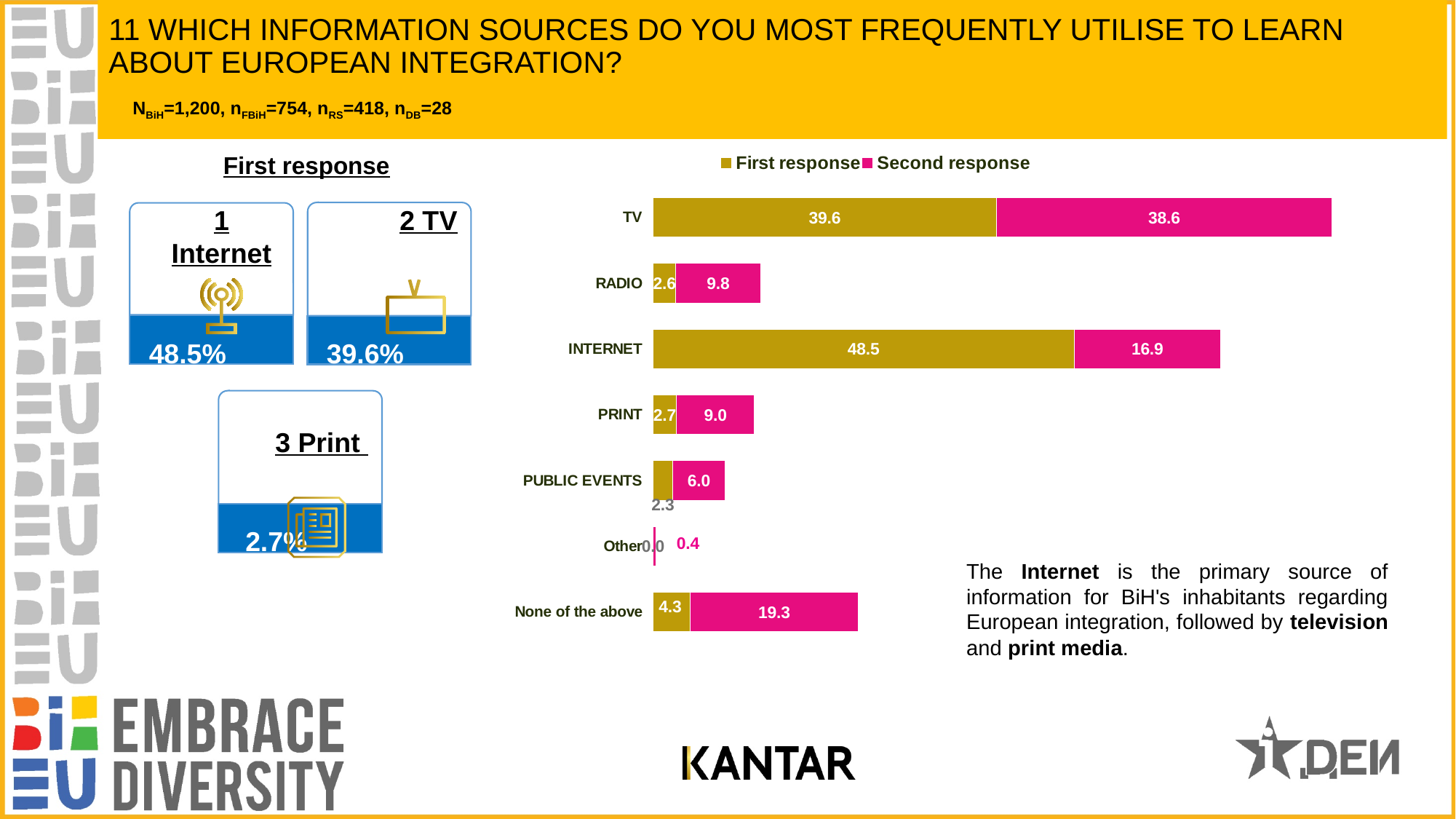
Which category has the lowest Second response value? Other What is the total of the stacked bar for TV? 78.2 What kind of chart is shown on the slide? Stacked bar chart What is the Second response value for TV? 38.6 Which is larger: the Second response value for RADIO or the Second response value for PRINT? RADIO What is the First response value for PUBLIC EVENTS? 2.3 What is the First response value for INTERNET? 48.5 Which category has the highest First response value? INTERNET How many series does the legend list? 2 What is the Second response value for None of the above? 19.3 How many categories are shown in the chart? 7 What is the difference between the First response and Second response values for INTERNET? 31.6